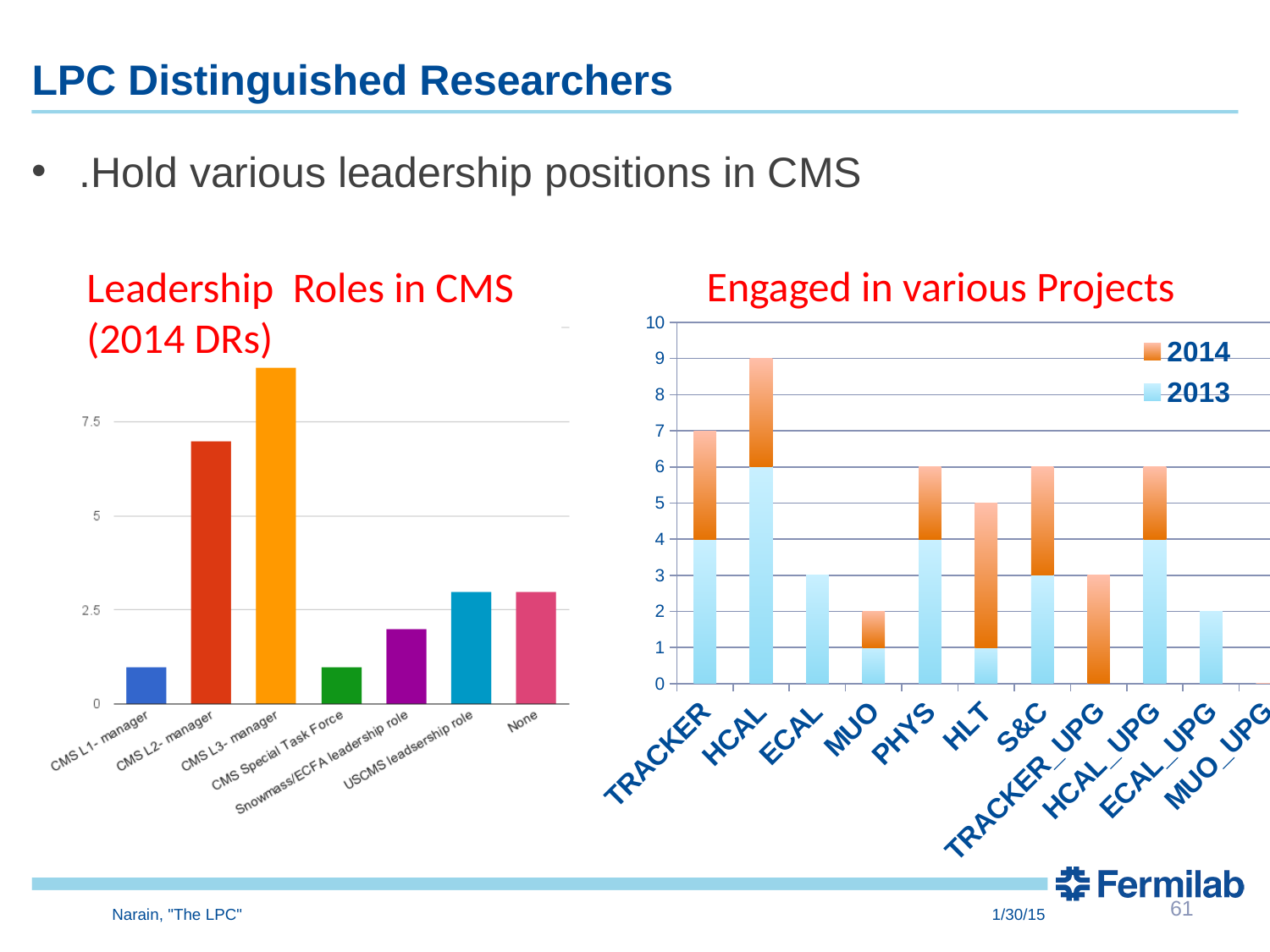
In the 'Engaged in various Projects' chart, what is the 2013 value for HCAL? 6 How many categories are shown on the x axis of the 'Engaged in various Projects' chart? 11 What kind of chart is the 'Engaged in various Projects' chart? stacked bar chart How many series does the legend of the 'Engaged in various Projects' chart list? 2 In the 'Engaged in various Projects' chart, which is larger, the total for PHYS or the total for HLT? PHYS In the 'Engaged in various Projects' chart, what is the total of the stacked bar for MUO? 2 In the 'Engaged in various Projects' chart, which project has the highest total bar? HCAL In the 'Leadership Roles in CMS (2014 DRs)' chart, is the value for CMS L2- manager greater or less than 5? greater How many categories are shown in the 'Leadership Roles in CMS (2014 DRs)' chart? 7 In the 'Leadership Roles in CMS (2014 DRs)' chart, which category has the highest bar? CMS L3- manager In the 'Engaged in various Projects' chart, what is the total of the stacked bar for TRACKER? 7 In the 'Engaged in various Projects' chart, what is the 2013 value for TRACKER? 4